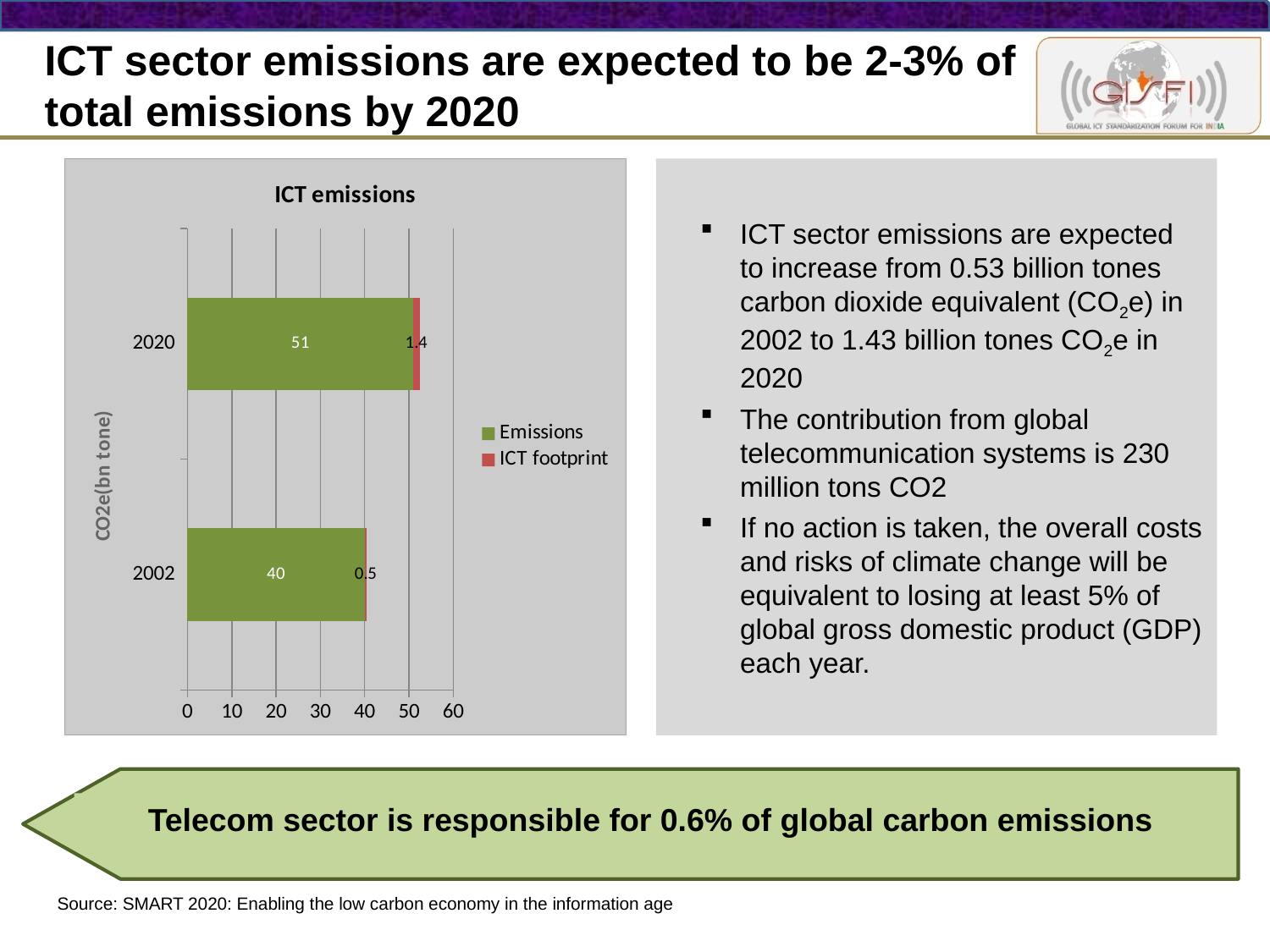
What is the Emissions value for 2002? 40 What is the ICT footprint value for 2002? 0.5 What is the title of the chart? ICT emissions What is the label on the vertical axis of the chart? CO2e(bn tone) How many series does the chart legend list? 2 How many categories are shown on the chart? 2 What is the Emissions value for 2020? 51 Which year has the higher Emissions value? 2020 What type of chart is shown on the slide? bar chart What is the total of the stacked bar for 2020? 52.4 What is the difference between the Emissions values for 2020 and 2002? 11 What is the ICT footprint value for 2020? 1.4